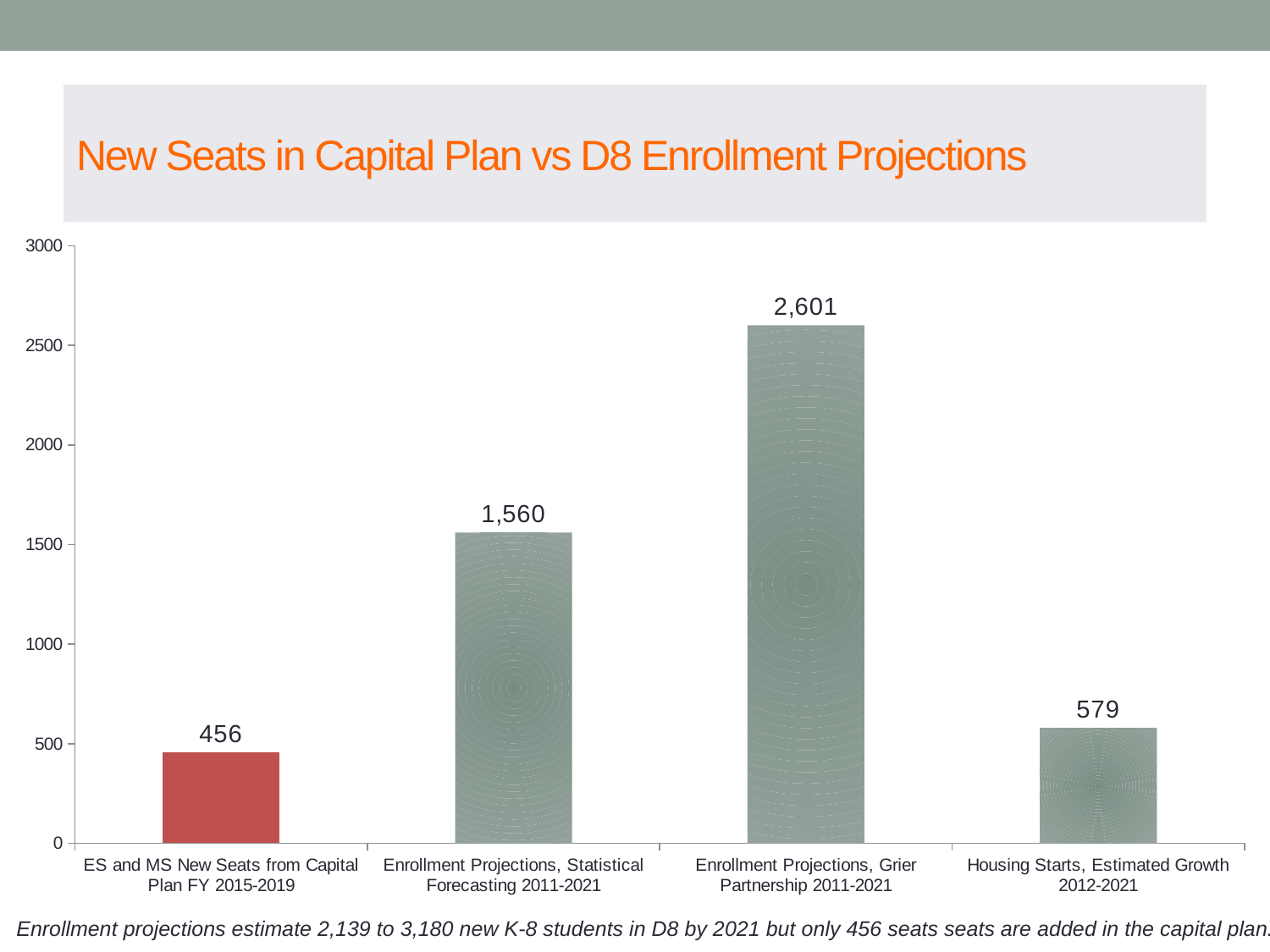
What is the difference between Housing Starts, Estimated Growth 2012-2021 and ES and MS New Seats from Capital Plan FY 2015-2019? 123 What is the value for ES and MS New Seats from Capital Plan FY 2015-2019? 456 Which category has the lowest value? ES and MS New Seats from Capital Plan FY 2015-2019 What kind of chart is shown on the slide? Bar chart What is the value for Enrollment Projections, Grier Partnership 2011-2021? 2,601 What is the value for Enrollment Projections, Statistical Forecasting 2011-2021? 1,560 What is the value for Housing Starts, Estimated Growth 2012-2021? 579 Which category has the highest value? Enrollment Projections, Grier Partnership 2011-2021 What is the difference between the Grier Partnership enrollment projection and the Statistical Forecasting enrollment projection? 1,041 Which is larger: Housing Starts, Estimated Growth 2012-2021 or ES and MS New Seats from Capital Plan FY 2015-2019? Housing Starts, Estimated Growth 2012-2021 How many categories are shown on the chart? 4 What is the title of the chart? New Seats in Capital Plan vs D8 Enrollment Projections